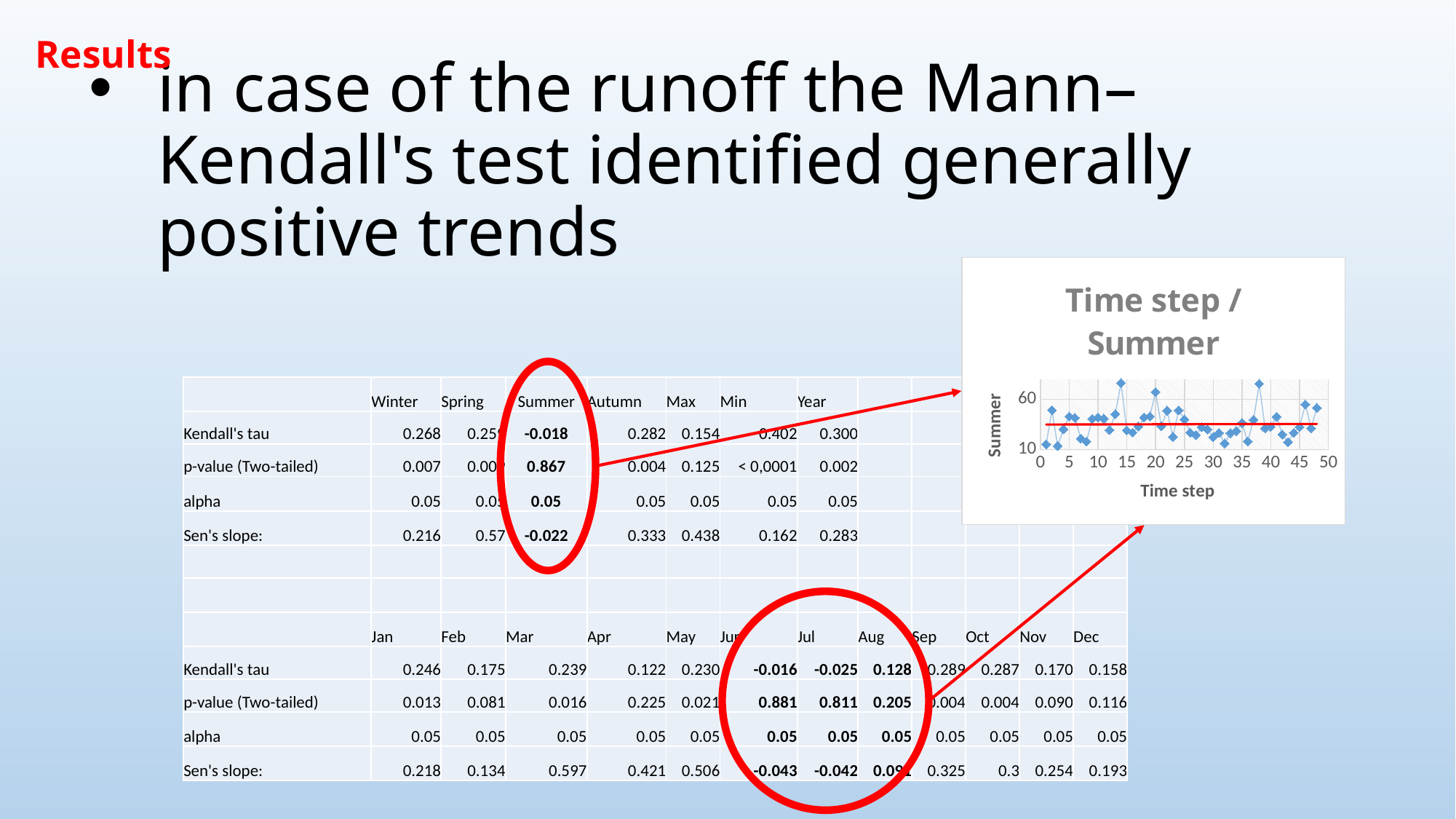
On the "Time step / Summer" chart, is the highest plotted value greater or less than 60? greater What is the lowest tick value shown on the y axis of the "Time step / Summer" chart? 10 What kind of chart is the "Time step / Summer" chart? scatter chart What is the label of the y axis on the "Time step / Summer" chart? Summer What colour are the data markers on the "Time step / Summer" chart? blue What is the label of the x axis on the "Time step / Summer" chart? Time step On the "Time step / Summer" chart, is the value at time step 25 greater or less than 60? less What is the highest tick value shown on the x axis of the "Time step / Summer" chart? 50 How many tick labels are shown on the x axis of the "Time step / Summer" chart? 11